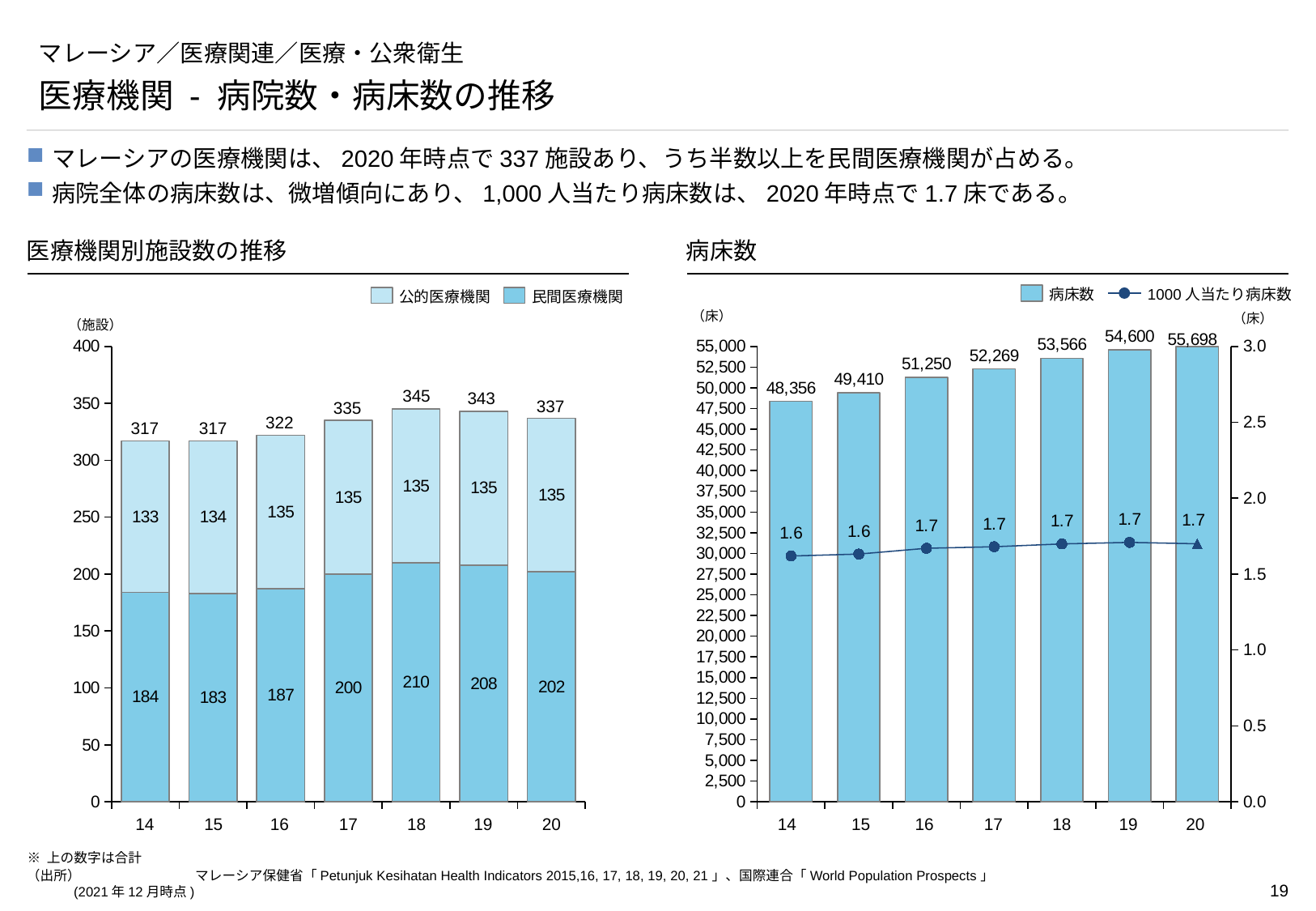
In the chart titled 病床数, which year has the lowest 病床数? 14 In the chart titled 医療機関別施設数の推移, what is the total of the stacked bar for 20? 337 In the chart titled 病床数, what is the difference in 病床数 between 20 and 19? 1,098 In the chart titled 病床数, what is the value for 1000人当たり病床数 in 15? 1.6 In the chart titled 医療機関別施設数の推移, which year has the highest total number of facilities? 18 In the chart titled 医療機関別施設数の推移, what is the difference between the 民間医療機関 values for 17 and 16? 13 In the chart titled 医療機関別施設数の推移, what is the value for 民間医療機関 in 18? 210 In the chart titled 医療機関別施設数の推移, what is the value for 公的医療機関 in 14? 133 In the chart titled 医療機関別施設数の推移, what kind of chart is it? Stacked bar chart In the chart titled 病床数, do the 病床数 values rise or fall from 14 to 20? Rise In the chart titled 医療機関別施設数の推移, how many series does the legend list? 2 In the chart titled 病床数, what is the value for 病床数 in 17? 52,269